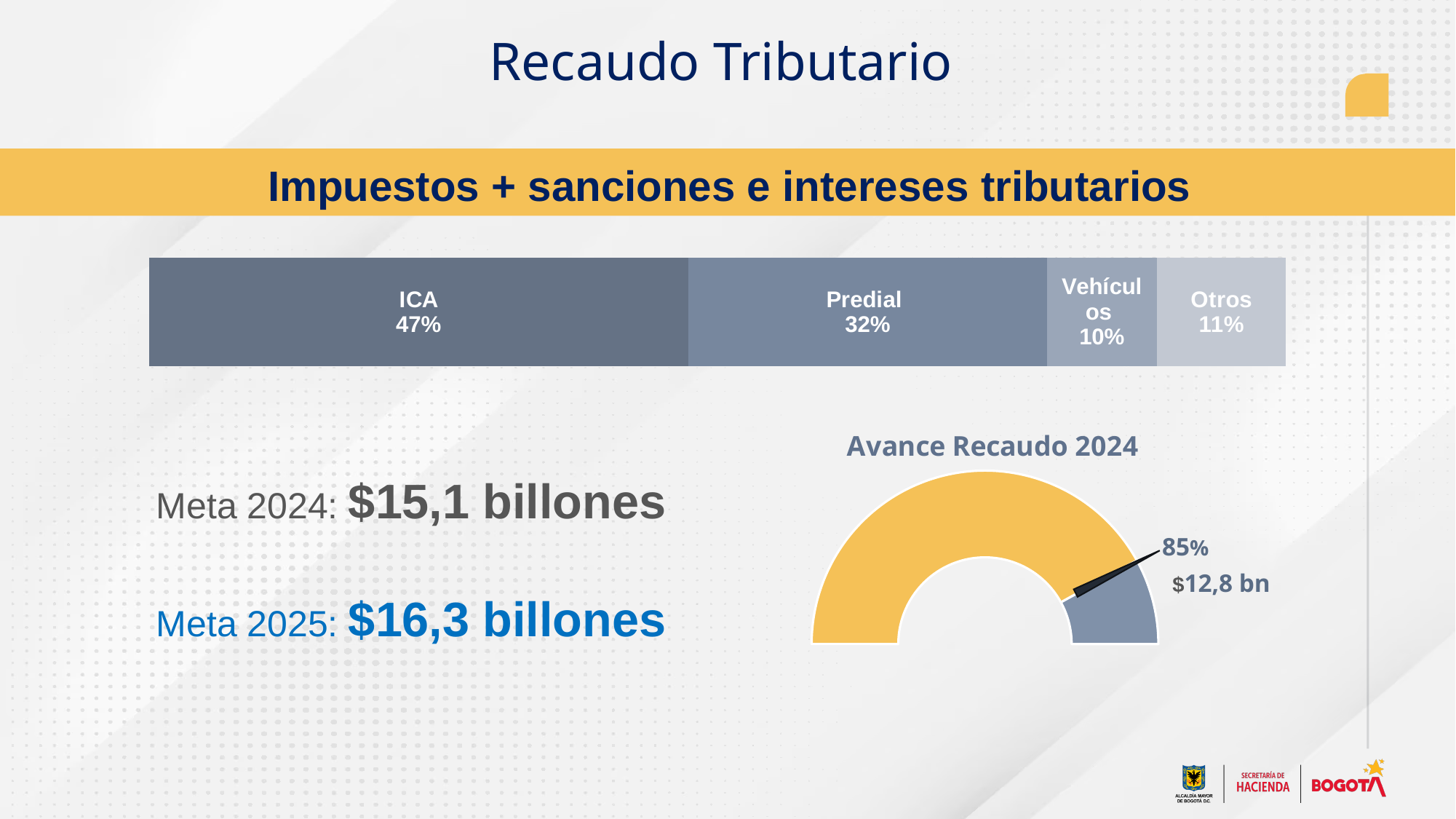
In the stacked bar chart at the top of the slide, what is the difference in percentage points between ICA and Predial? 15 In the 'Avance Recaudo 2024' gauge chart, what percentage of progress is shown? 85% In the stacked bar chart at the top of the slide, what share does ICA represent? 47% In the stacked bar chart at the top of the slide, what share does Vehículos represent? 10% How many segments does the stacked bar chart at the top of the slide have? 4 In the 'Avance Recaudo 2024' gauge chart, what amount is shown next to the 85% label? $12,8 bn In the stacked bar chart at the top of the slide, which segment is the smallest? Vehículos In the stacked bar chart at the top of the slide, which is larger, Predial or Otros? Predial What kind of chart is shown at the top of the slide under the heading 'Impuestos + sanciones e intereses tributarios'? Stacked bar chart In the stacked bar chart at the top of the slide, what share does Predial represent? 32% In the stacked bar chart at the top of the slide, what share does Otros represent? 11% In the stacked bar chart at the top of the slide, which segment is the largest? ICA